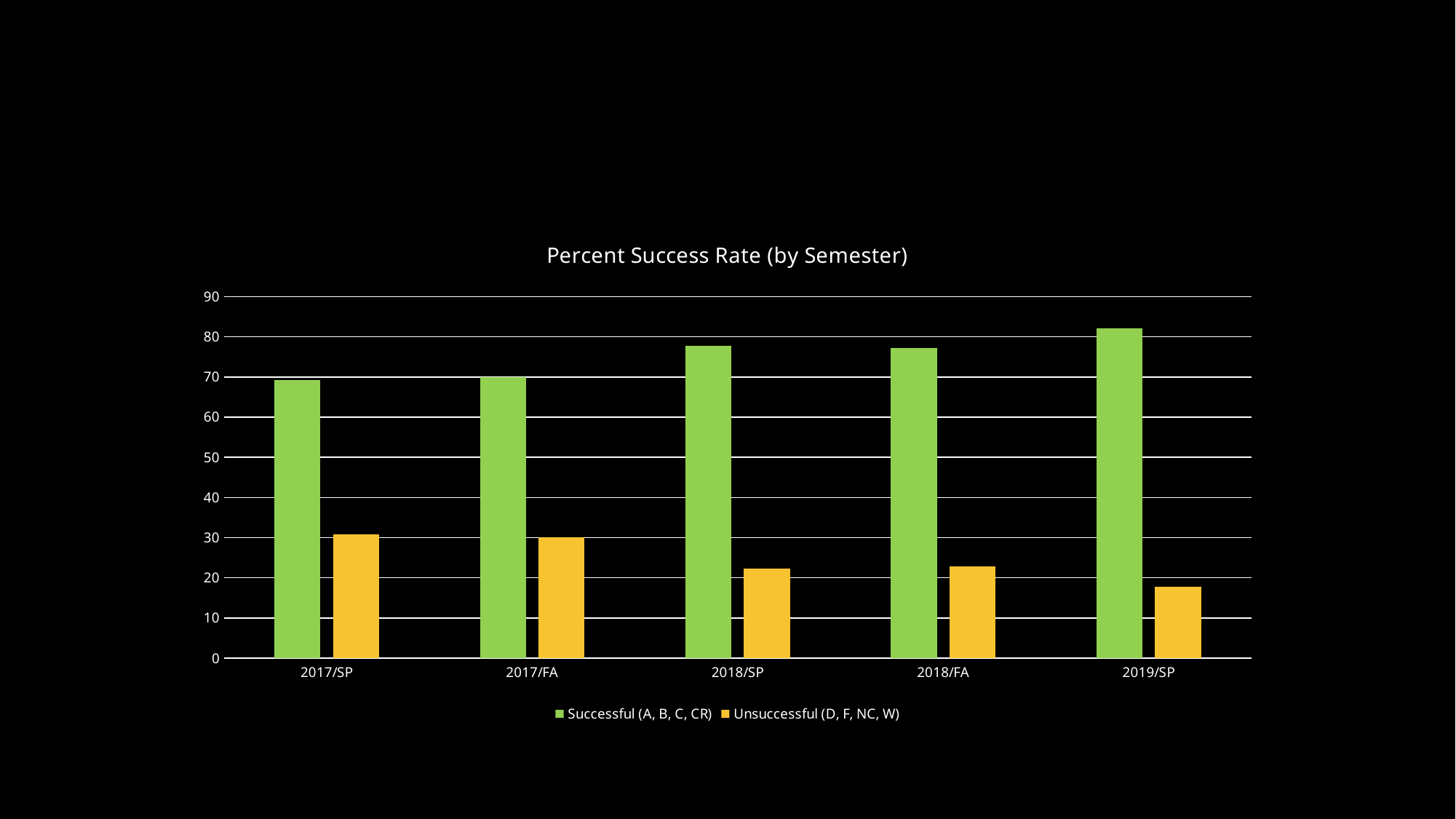
Which is larger: the Unsuccessful (D, F, NC, W) value for 2017/SP or for 2018/SP? 2017/SP Is the Successful (A, B, C, CR) value for 2017/FA greater or less than 60? greater Which semester has the lowest Unsuccessful (D, F, NC, W) value? 2019/SP Do the Unsuccessful (D, F, NC, W) values generally rise or fall from 2017/SP to 2019/SP? fall Which semester has the highest Successful (A, B, C, CR) value? 2019/SP Is the Unsuccessful (D, F, NC, W) value for 2019/SP greater or less than 20? less Is the Unsuccessful (D, F, NC, W) value for 2018/SP greater or less than 30? less What kind of chart is shown on the slide? bar chart How many series does the legend list? 2 How many semesters are shown on the x axis? 5 What is the title of the chart? Percent Success Rate (by Semester)